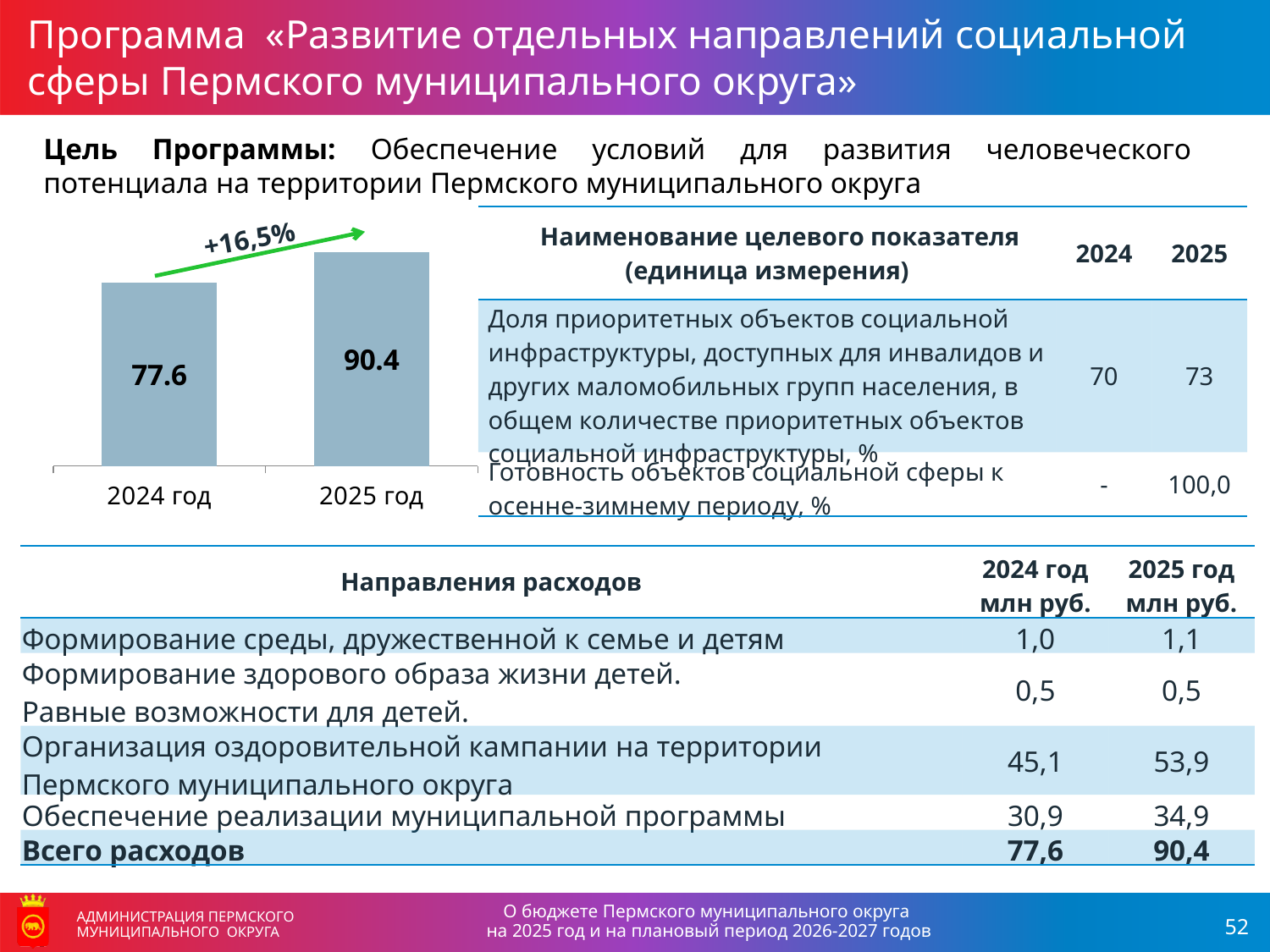
What colour are the bars in the bar chart? grey-blue What is the value shown for 2025 год in the bar chart? 90.4 Do the values in the bar chart rise or fall from 2024 год to 2025 год? rise What is the difference between the values for 2025 год and 2024 год in the bar chart? 12.8 What kind of chart is shown on the slide? bar chart Which category has the lowest value in the bar chart? 2024 год What is the value shown for 2024 год in the bar chart? 77.6 Which is larger in the bar chart: the value for 2024 год or for 2025 год? 2025 год What percentage change is annotated above the bars in the bar chart? +16,5% Which category has the highest value in the bar chart? 2025 год How many bars are plotted in the bar chart? 2